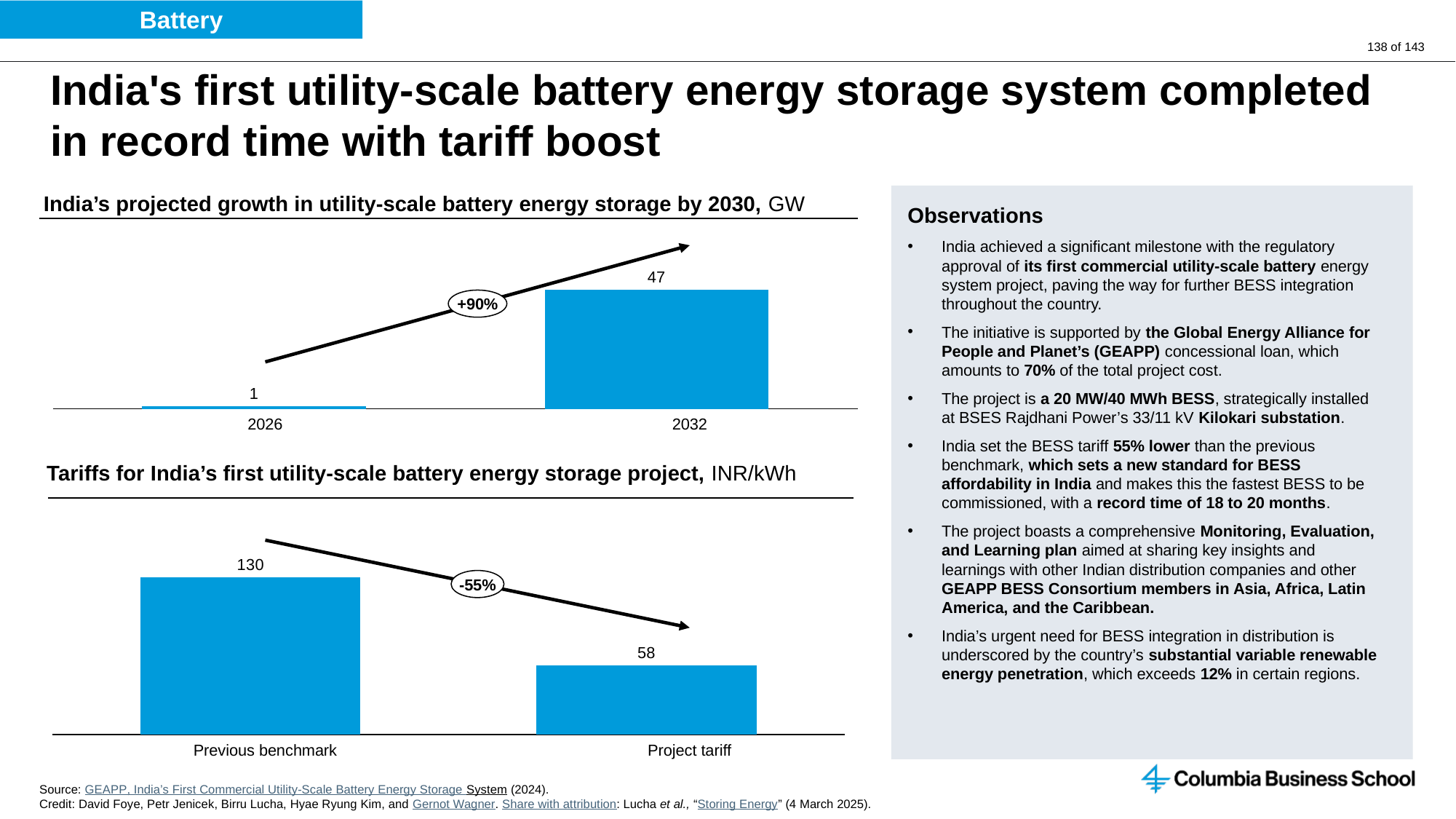
In the chart 'Tariffs for India's first utility-scale battery energy storage project', which category has the lower value? Project tariff In the chart 'India's projected growth in utility-scale battery energy storage by 2030', what is the value for 2032? 47 In the chart 'Tariffs for India's first utility-scale battery energy storage project', how many categories are shown? 2 What type of chart is 'Tariffs for India's first utility-scale battery energy storage project'? Bar chart In the chart 'Tariffs for India's first utility-scale battery energy storage project', what is the value for Previous benchmark? 130 In the chart 'Tariffs for India's first utility-scale battery energy storage project', do the values rise or fall from Previous benchmark to Project tariff? Fall In the chart 'India's projected growth in utility-scale battery energy storage by 2030', what is the value for 2026? 1 In the chart 'India's projected growth in utility-scale battery energy storage by 2030', what percentage change is labelled on the arrow? +90% In the chart 'India's projected growth in utility-scale battery energy storage by 2030', what is the difference between the 2032 and 2026 values? 46 In the chart 'Tariffs for India's first utility-scale battery energy storage project', what is the difference between Previous benchmark and Project tariff? 72 In the chart 'Tariffs for India's first utility-scale battery energy storage project', what is the value for Project tariff? 58 In the chart 'India's projected growth in utility-scale battery energy storage by 2030', what unit is stated in the title? GW